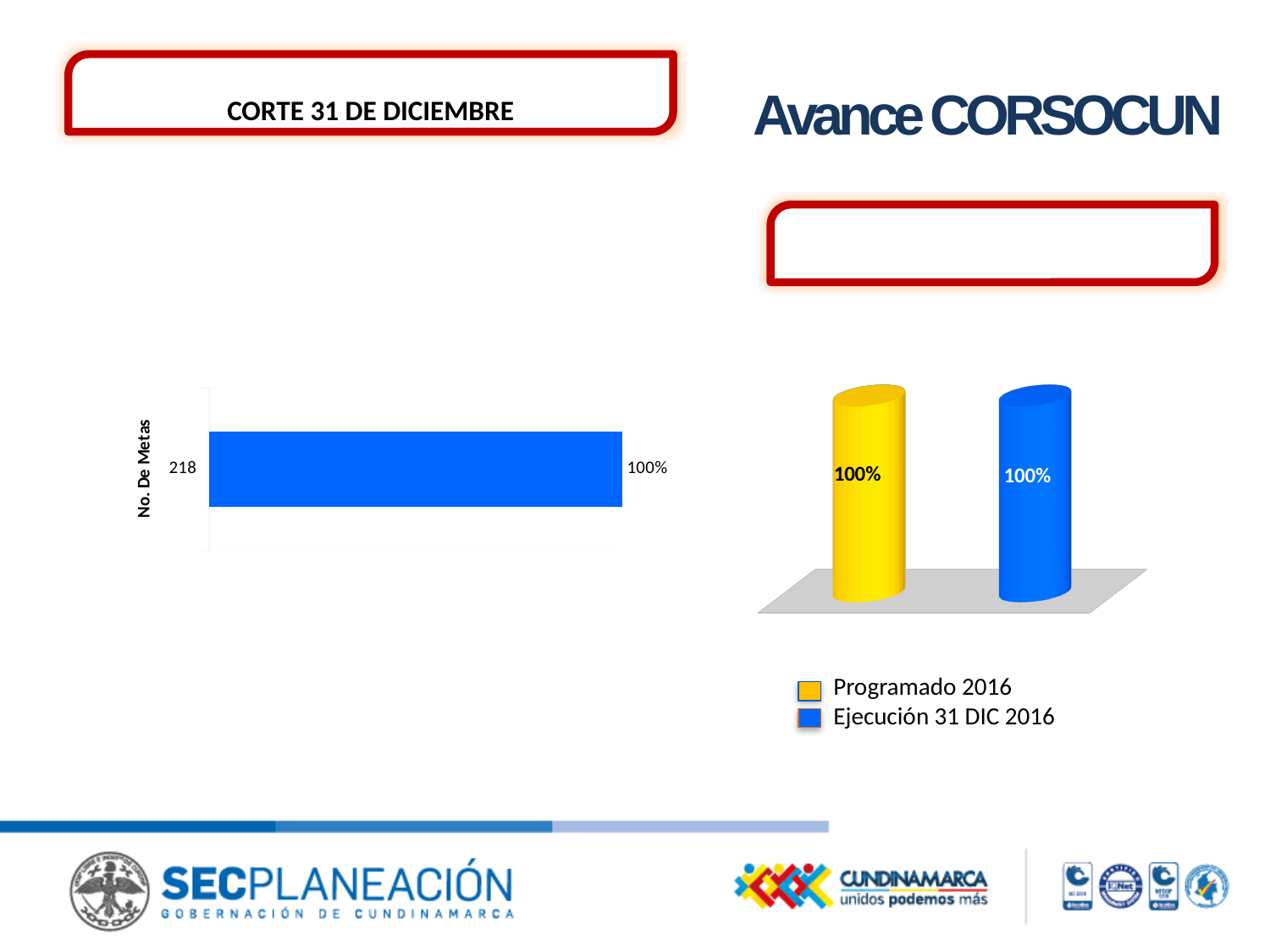
On the right chart, how many series does the legend list? 2 On the right chart, what is the difference between the Programado 2016 value and the Ejecución 31 DIC 2016 value? 0% On the left chart, what is the data label shown on the bar for category 218? 100% On the right chart, which colour represents Programado 2016? yellow On the left chart, is the value for category 218 greater or less than 50%? greater On the right chart, what is the value for Programado 2016? 100% On the right chart, how many bars are plotted? 2 On the left chart, what is the label of the vertical axis? No. De Metas On the left chart, how many bars are plotted? 1 On the right chart, what is the value for Ejecución 31 DIC 2016? 100% What kind of chart is the left chart? bar chart What kind of chart is the right chart? bar chart